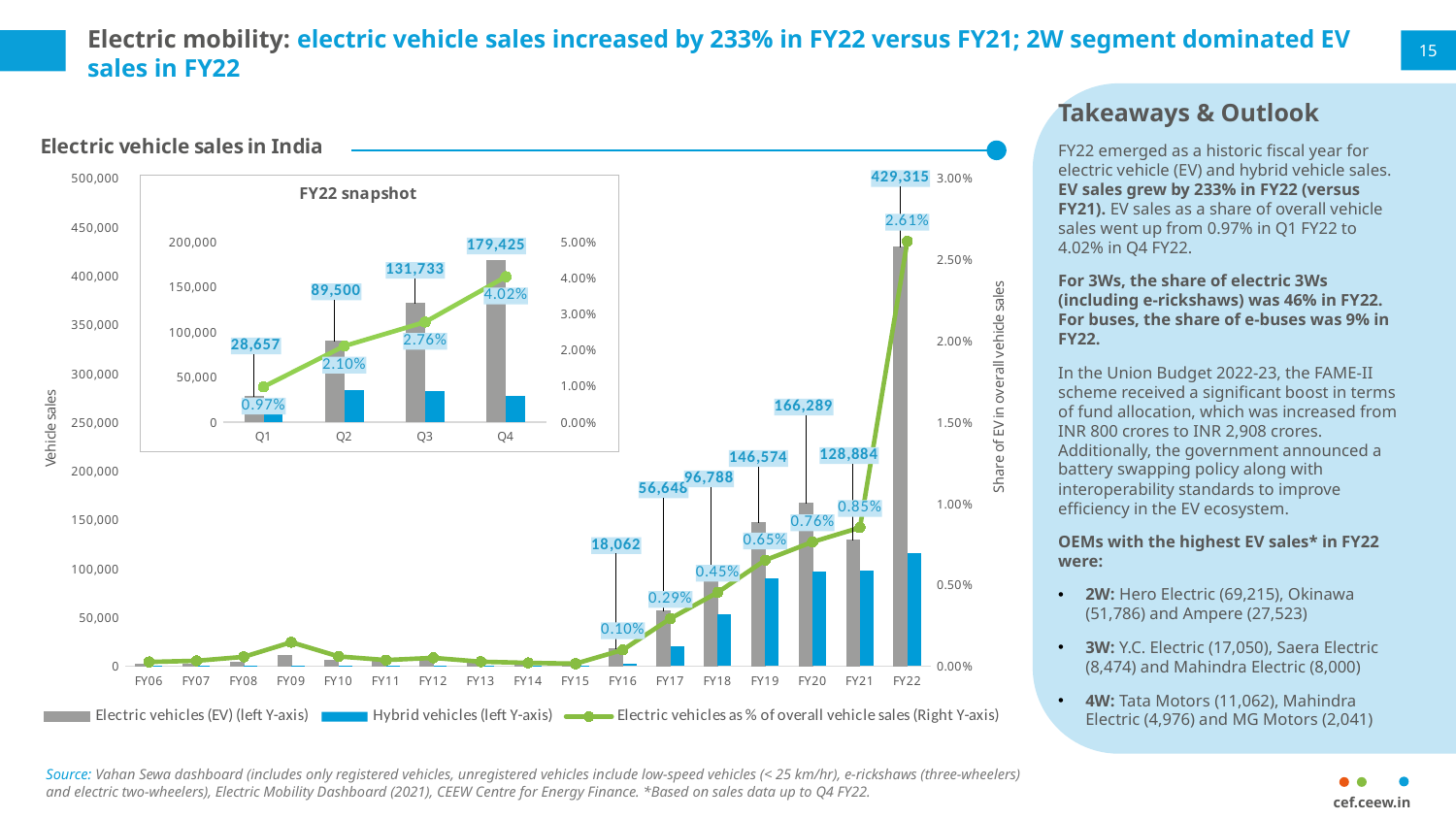
In the 'Electric vehicle sales in India' chart, which is larger: the electric vehicle sales labelled for FY18 or FY19? FY19 In the 'FY22 snapshot' chart, does the share of electric vehicles in overall vehicle sales rise or fall from Q1 to Q4? rise In the 'FY22 snapshot' chart, what is the difference between the electric vehicle sales labelled for Q4 and Q1? 150,768 In the 'Electric vehicle sales in India' chart, what share of overall vehicle sales did electric vehicles have in FY21? 0.85% In the 'FY22 snapshot' chart, what is the electric vehicle sales value labelled for Q3? 131,733 In the 'Electric vehicle sales in India' chart, which fiscal year has the highest labelled electric vehicle sales? FY22 In the 'Electric vehicle sales in India' chart, what is the difference between the electric vehicle sales labelled for FY20 and FY21? 37,405 In the 'Electric vehicle sales in India' chart, is the hybrid vehicles bar for FY22 greater or less than 100,000? greater In the 'Electric vehicle sales in India' chart, what is the electric vehicle sales value labelled for FY22? 429,315 In the 'Electric vehicle sales in India' chart, how many fiscal years are shown on the x axis? 17 In the 'FY22 snapshot' chart, what share of overall vehicle sales did electric vehicles have in Q4? 4.02% In the 'Electric vehicle sales in India' chart, how many series does the legend list? 3